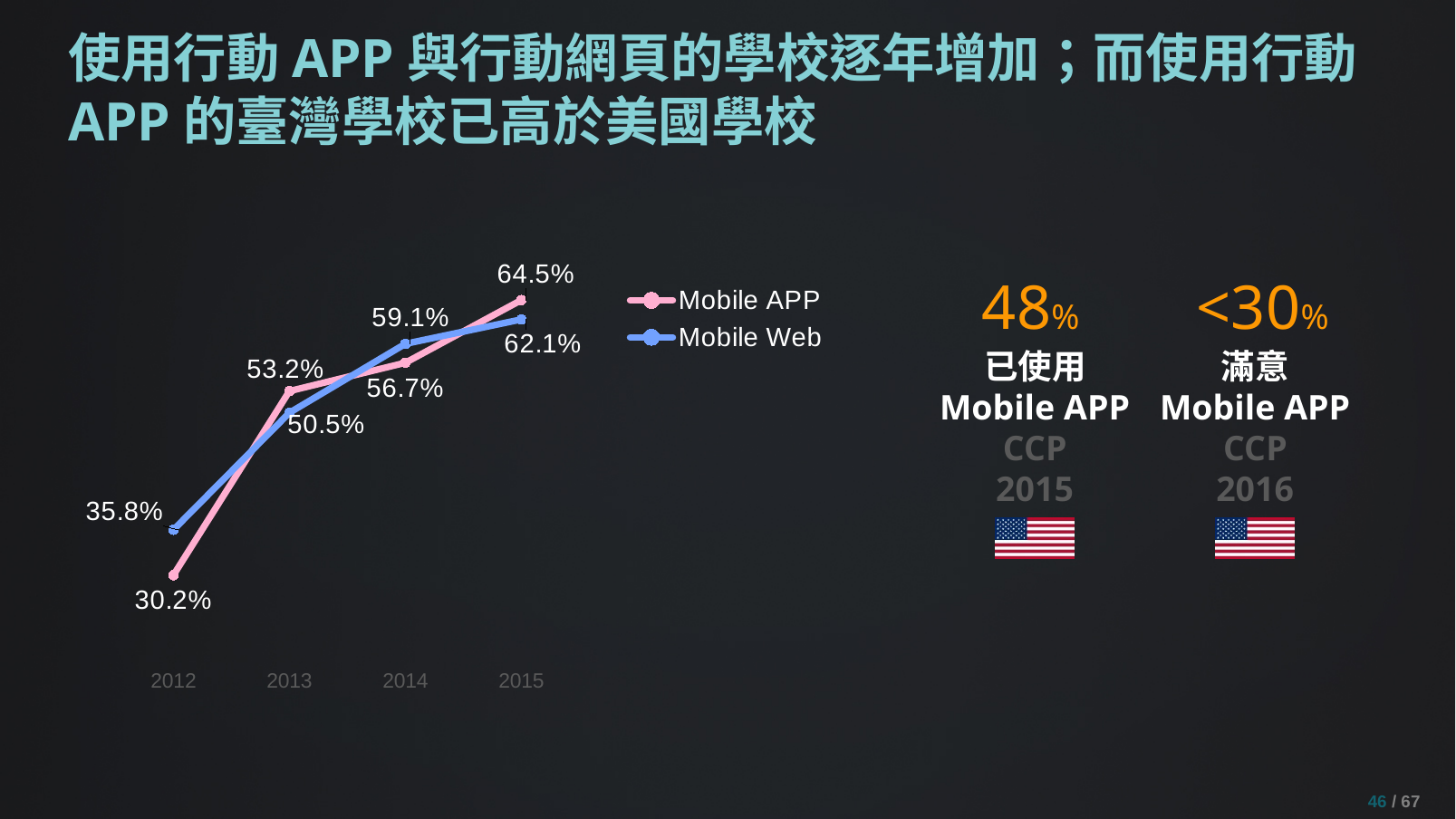
How many series does the chart legend list? 2 What is the difference between the Mobile APP and Mobile Web values in 2015? 2.4% What is the value for Mobile Web in 2014? 59.1% What is the value for Mobile Web in 2013? 50.5% What type of chart is shown on the slide? line chart How many years are plotted on the x axis? 4 Which series has the larger value in 2012, Mobile APP or Mobile Web? Mobile Web What is the value for Mobile APP in 2015? 64.5% Does the Mobile Web series rise or fall from 2012 to 2015? rise What is the value for Mobile APP in 2012? 30.2% In which year is the Mobile APP value lowest? 2012 In which year is the Mobile Web value highest? 2015